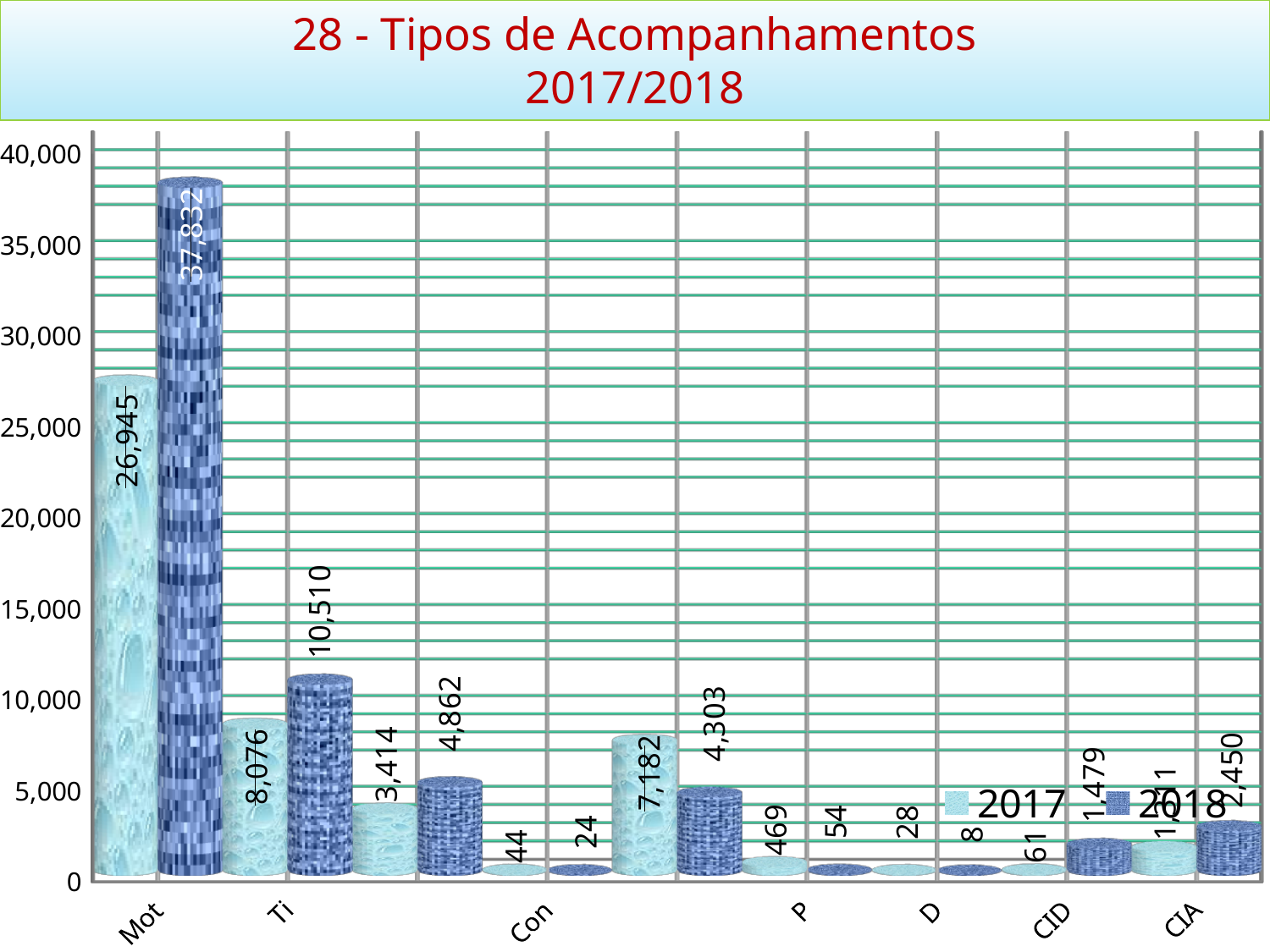
What is the value for Ti in the 2017 series? 8,076 Which category has the highest value in the 2018 series? Mot Which category has the lowest value in the 2018 series? D How many series does the legend list? 2 What is the value for D in the 2017 series? 28 For Ti, which series has the larger value, 2017 or 2018? 2018 What is the difference between the 2018 and 2017 values for Mot? 10,887 What is the value for P in the 2017 series? 469 What is the value for Con in the 2018 series? 24 What is the value for Mot in the 2018 series? 37,832 What kind of chart is shown on the slide? Bar chart What is the value for CID in the 2018 series? 1,479